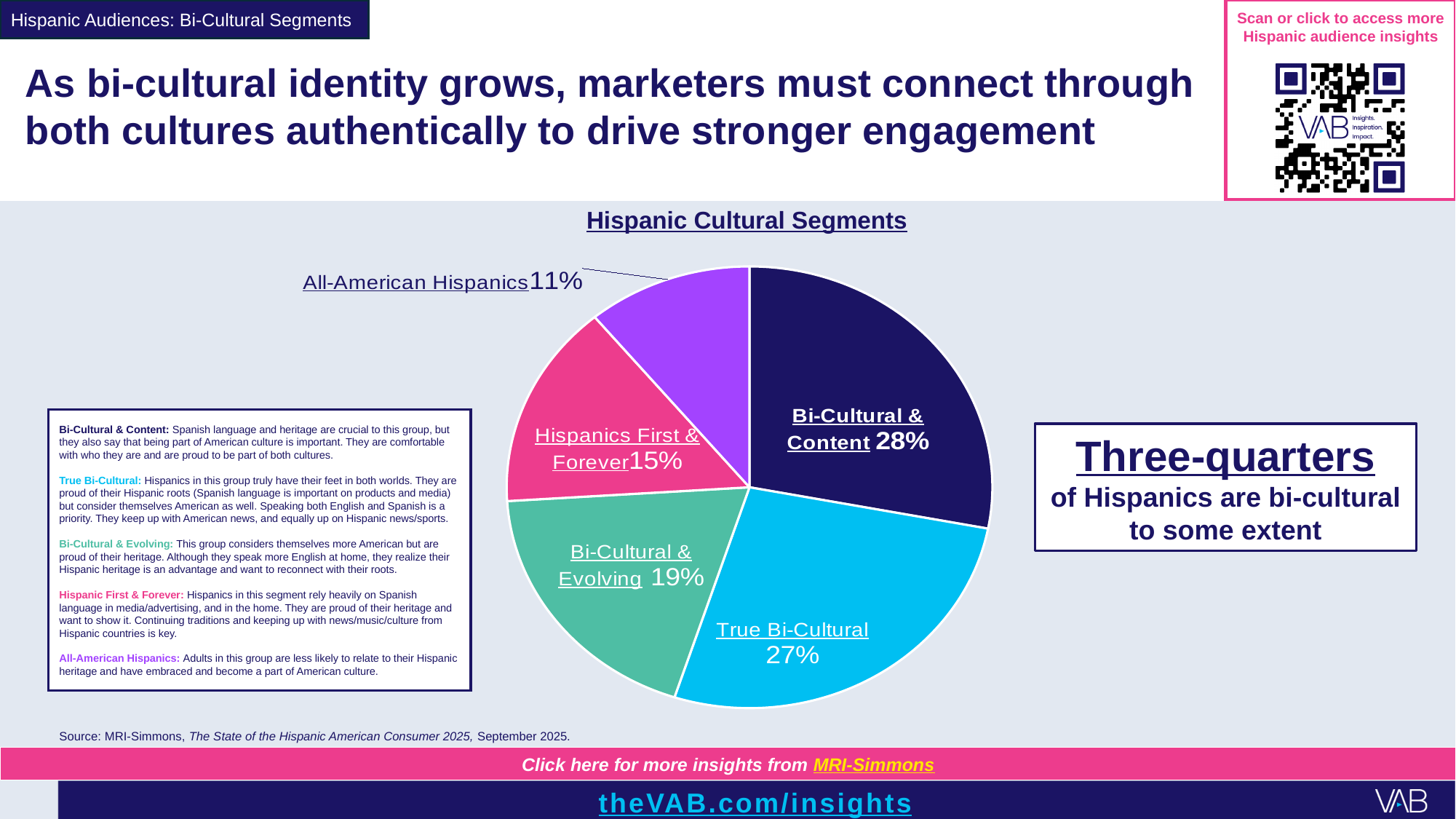
What percentage of the pie is the Bi-Cultural & Content segment? 28% What percentage of the pie is the All-American Hispanics segment? 11% Which segment has the smallest share of the pie? All-American Hispanics What percentage of the pie is the True Bi-Cultural segment? 27% What percentage of the pie is the Hispanics First & Forever segment? 15% How many segments does the pie chart have? 5 Which is larger: the Hispanics First & Forever segment or the Bi-Cultural & Evolving segment? Bi-Cultural & Evolving What type of chart is shown under the title "Hispanic Cultural Segments"? Pie chart What percentage of the pie is the Bi-Cultural & Evolving segment? 19% What is the title of the chart? Hispanic Cultural Segments What is the difference in percentage points between the Bi-Cultural & Evolving and All-American Hispanics segments? 8 percentage points Which segment has the largest share of the pie? Bi-Cultural & Content